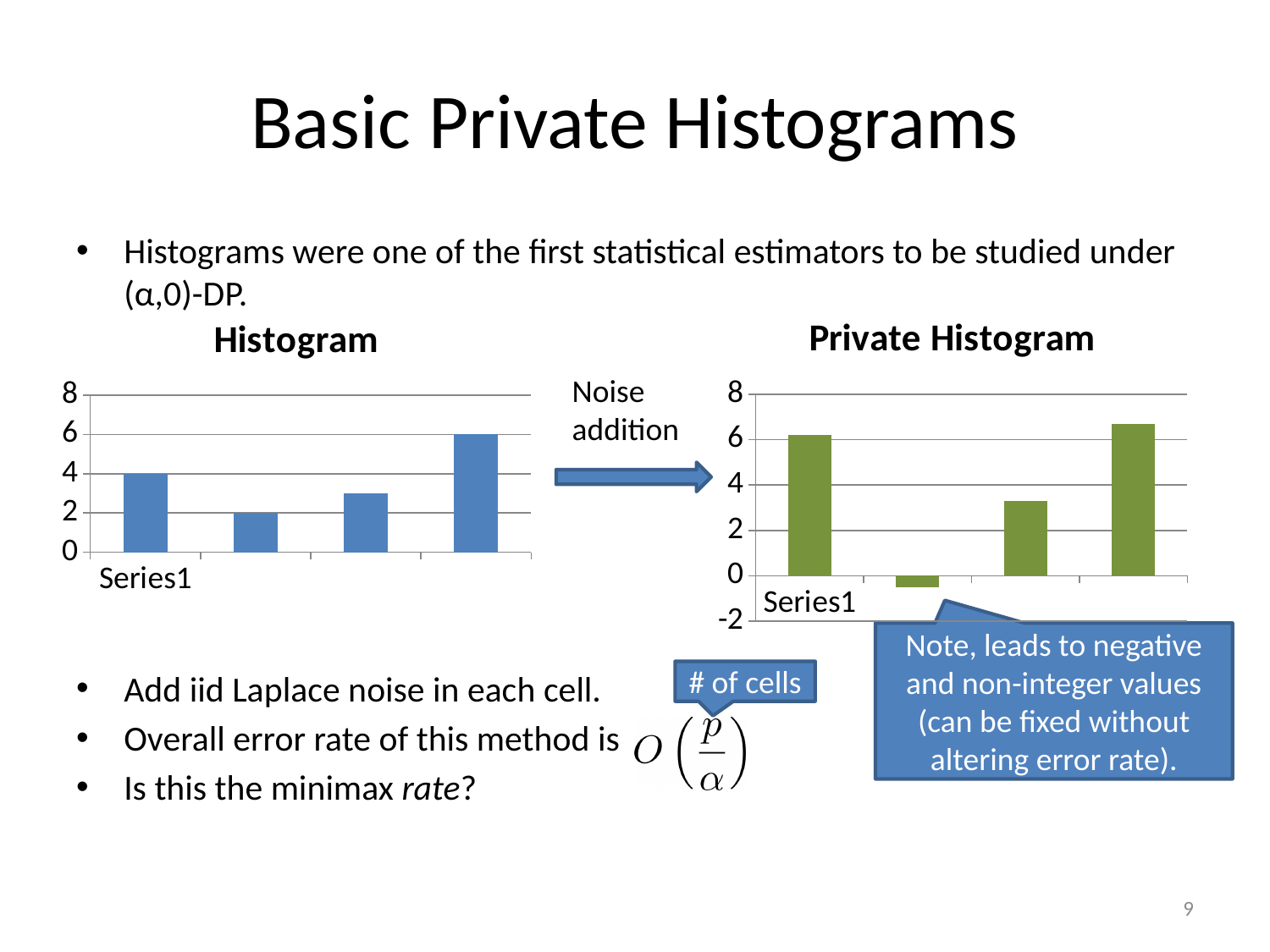
In the chart titled "Private Histogram", which bar has the lowest value? the second bar In the chart titled "Histogram", what is the value of the first bar? 4 In the chart titled "Histogram", what is the value of the second bar? 2 What type of chart is the chart titled "Histogram"? bar chart In the chart titled "Histogram", which bar is the tallest? the fourth (rightmost) bar In the chart titled "Histogram", what is the value of the fourth (rightmost) bar? 6 In the chart titled "Private Histogram", is the value of the fourth (rightmost) bar greater or less than 6? greater In the chart titled "Histogram", is the value of the third bar greater or less than 4? less In the chart titled "Histogram", which bar is the shortest? the second bar In the chart titled "Histogram", what is the difference between the fourth bar and the first bar? 2 In the chart titled "Private Histogram", is the value of the second bar greater or less than 0? less How many bars are plotted in the chart titled "Private Histogram"? 4